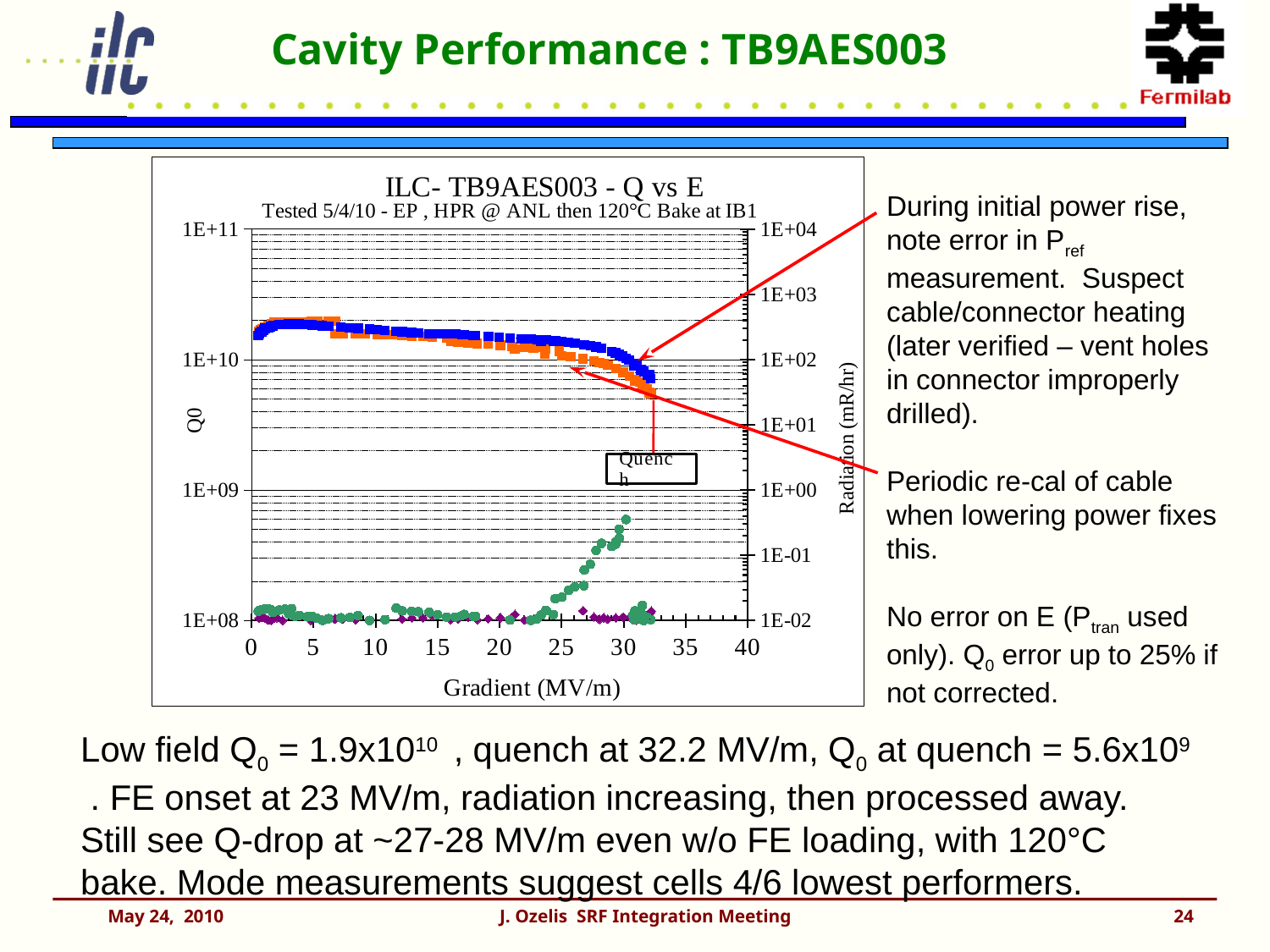
Is the radiation value at a gradient of 10 MV/m greater or less than 1E-01 mR/hr? less Does the Q0 series rise or fall as the gradient increases from 5 to 30 MV/m? fall What is the highest tick value shown on the left (Q0) axis of the chart? 1E+11 What is the lowest tick value shown on the right (Radiation) axis of the chart? 1E-02 Does the radiation series rise or fall as the gradient increases from 25 to 30 MV/m? rise Is the Q0 value at a gradient of 10 MV/m greater or less than 1E+10? greater What is the highest tick value shown on the x axis of the chart? 40 What kind of chart is shown on the slide? scatter chart Is the Q0 value at a gradient of 5 MV/m greater or less than 1E+11? less What is the label of the x axis of the chart? Gradient (MV/m) What is the title of the chart? ILC- TB9AES003 - Q vs E